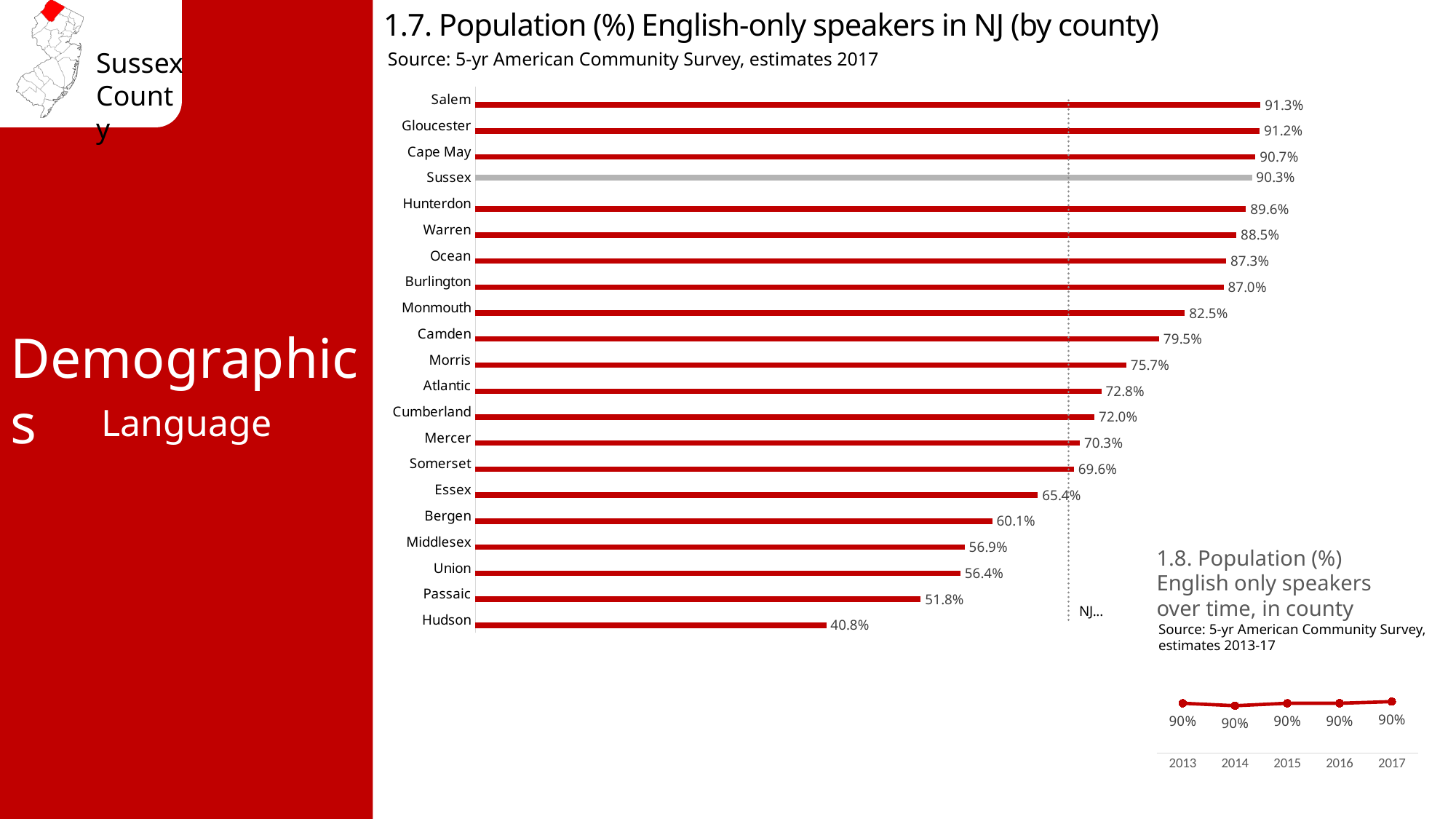
What kind of chart is chart 1.7? Bar chart In chart 1.7, what is the difference between the values for Salem and Hudson? 50.5% In chart 1.7 (Population (%) English-only speakers in NJ by county), what is the value for Sussex? 90.3% In chart 1.7, which bar is shown in grey instead of red? Sussex In chart 1.7, which county has the highest percentage of English-only speakers? Salem In chart 1.8 (Population (%) English only speakers over time, in county), what is the value for 2017? 90% In chart 1.7, which has a larger value, Morris or Bergen? Morris In chart 1.8, how many years are plotted? 5 In chart 1.7, how many counties are shown? 21 In chart 1.7, what is the value for Monmouth? 82.5% In chart 1.7, which county has the lowest percentage of English-only speakers? Hudson In chart 1.7, what is the value for Hudson? 40.8%